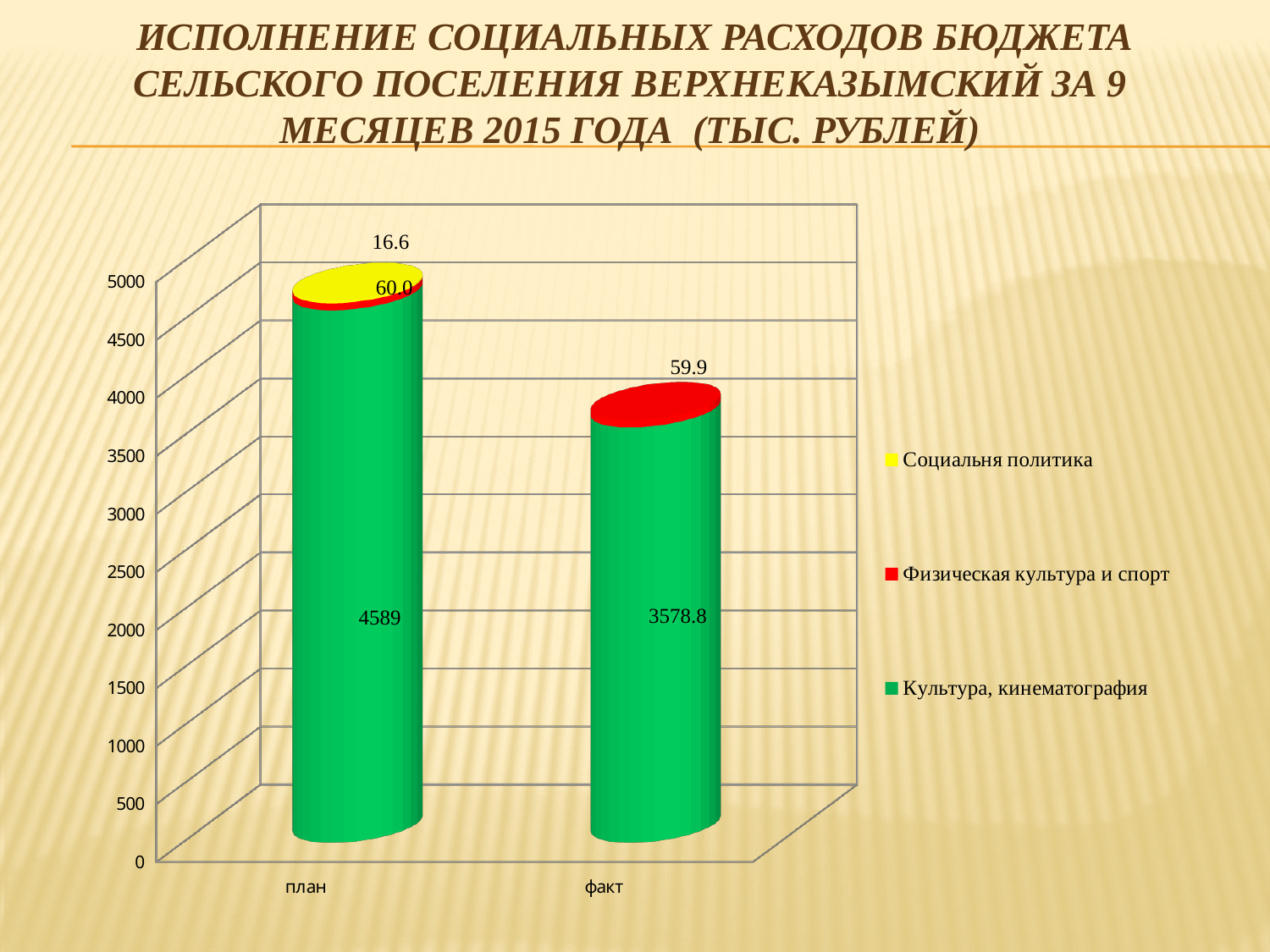
What is the value for Культура, кинематография in the план category? 4589 Which category has the larger value for Культура, кинематография, план or факт? план What kind of chart is shown on the slide? Stacked bar chart How many categories are shown on the x axis? 2 What is the value for Культура, кинематография in the факт category? 3578.8 What is the total of the stacked bar for план? 4665.6 What is the value for Социальня политика in the план category? 16.6 Which colour represents Физическая культура и спорт in the chart? Red How many series does the legend list? 3 What is the value for Физическая культура и спорт in the план category? 60.0 What is the difference between the Культура, кинематография values for план and факт? 1010.2 What is the value for Физическая культура и спорт in the факт category? 59.9